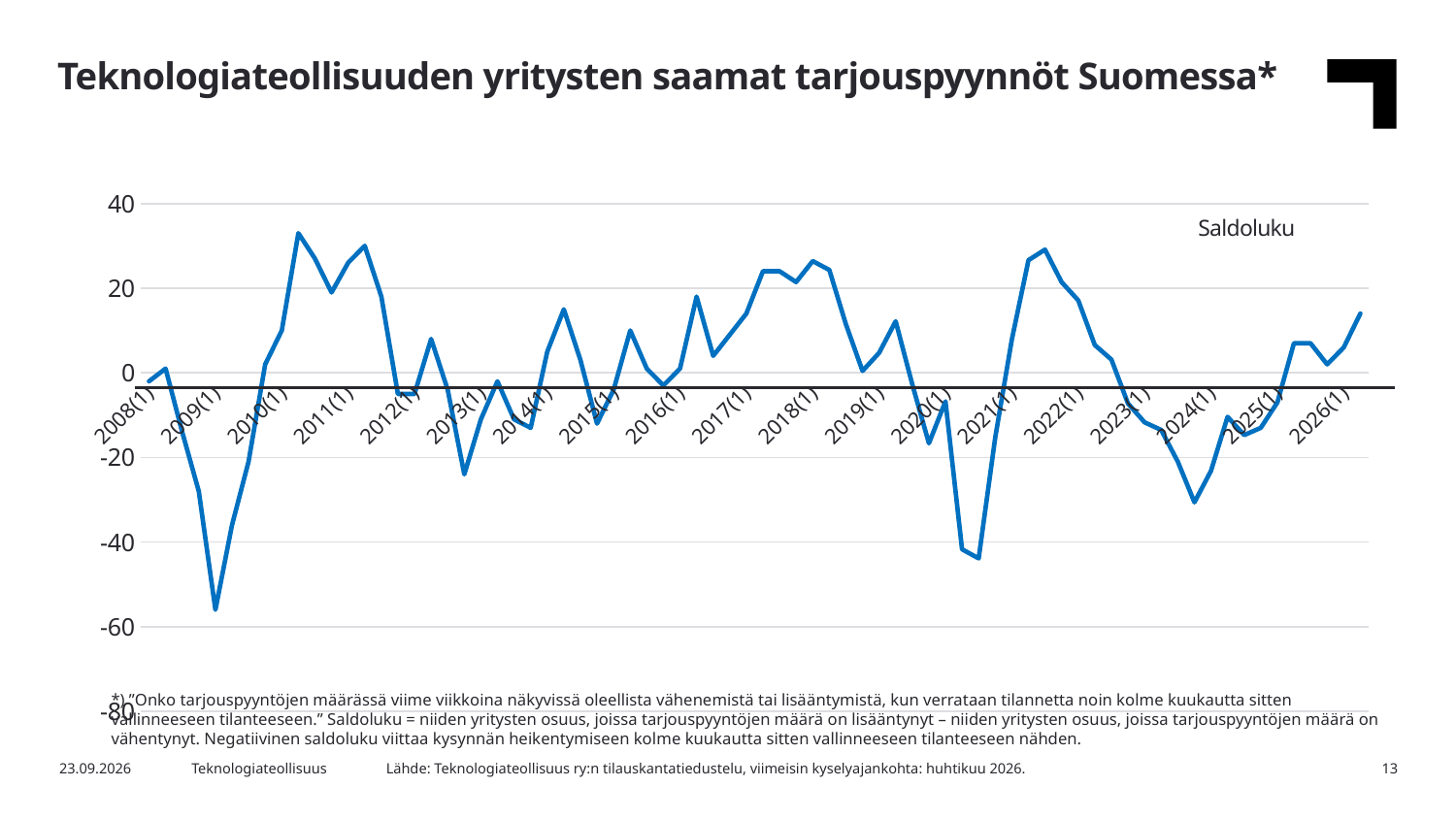
Does the Saldoluku line rise or fall between 2022(1) and 2024(1)? fall How many year labels are shown on the x axis of the chart? 19 Is the value for 2024(1) greater or less than -20? less Is the highest value of the Saldoluku line greater or less than 20? greater Does the Saldoluku line rise or fall between 2024(1) and 2026(1)? rise What is the title of the chart on the slide? Teknologiateollisuuden yritysten saamat tarjouspyynnöt Suomessa* Is the value for 2022(1) greater or less than 20? less How many series does the chart's legend list? 1 What kind of chart is shown on the slide? line chart What is the name of the series shown in the chart? Saldoluku